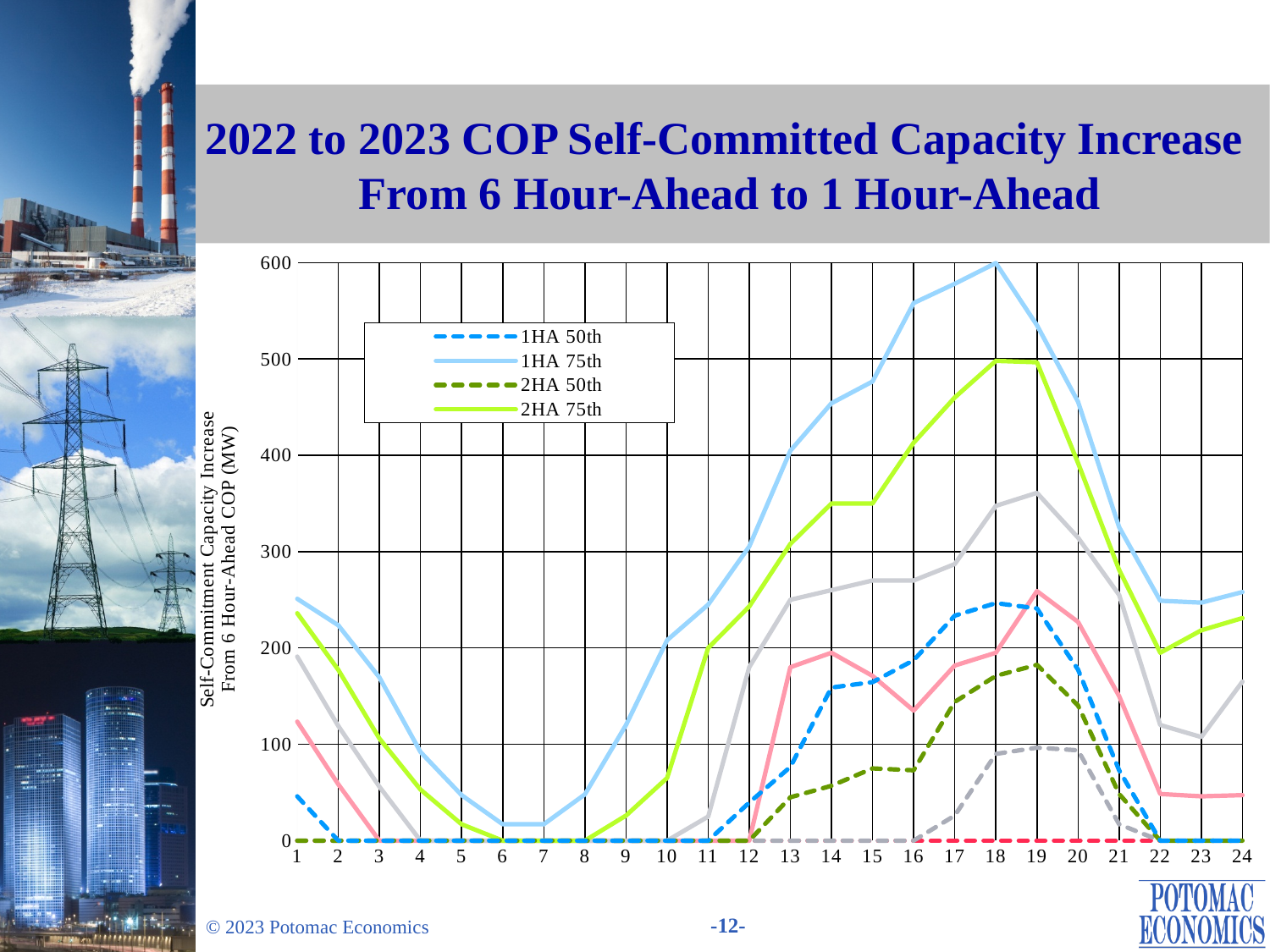
At hour 14, which is larger: 1HA 75th or 2HA 75th? 1HA 75th What kind of chart is shown on the slide? line chart Is the value for 1HA 75th at hour 6 greater or less than 100? less Is the value for 1HA 75th at hour 18 greater or less than 500? greater Does the 1HA 75th series rise or fall from hour 1 to hour 6? fall How many hours are shown along the x axis of the chart? 24 What is the title of the chart's y axis? Self-Commitment Capacity Increase From 6 Hour-Ahead COP (MW) Is the value for 2HA 75th at hour 18 greater or less than 400? greater Which series reaches the highest value on the chart? 1HA 75th At which hour does the 1HA 75th series reach its highest value? 18 How many series does the chart legend list? 4